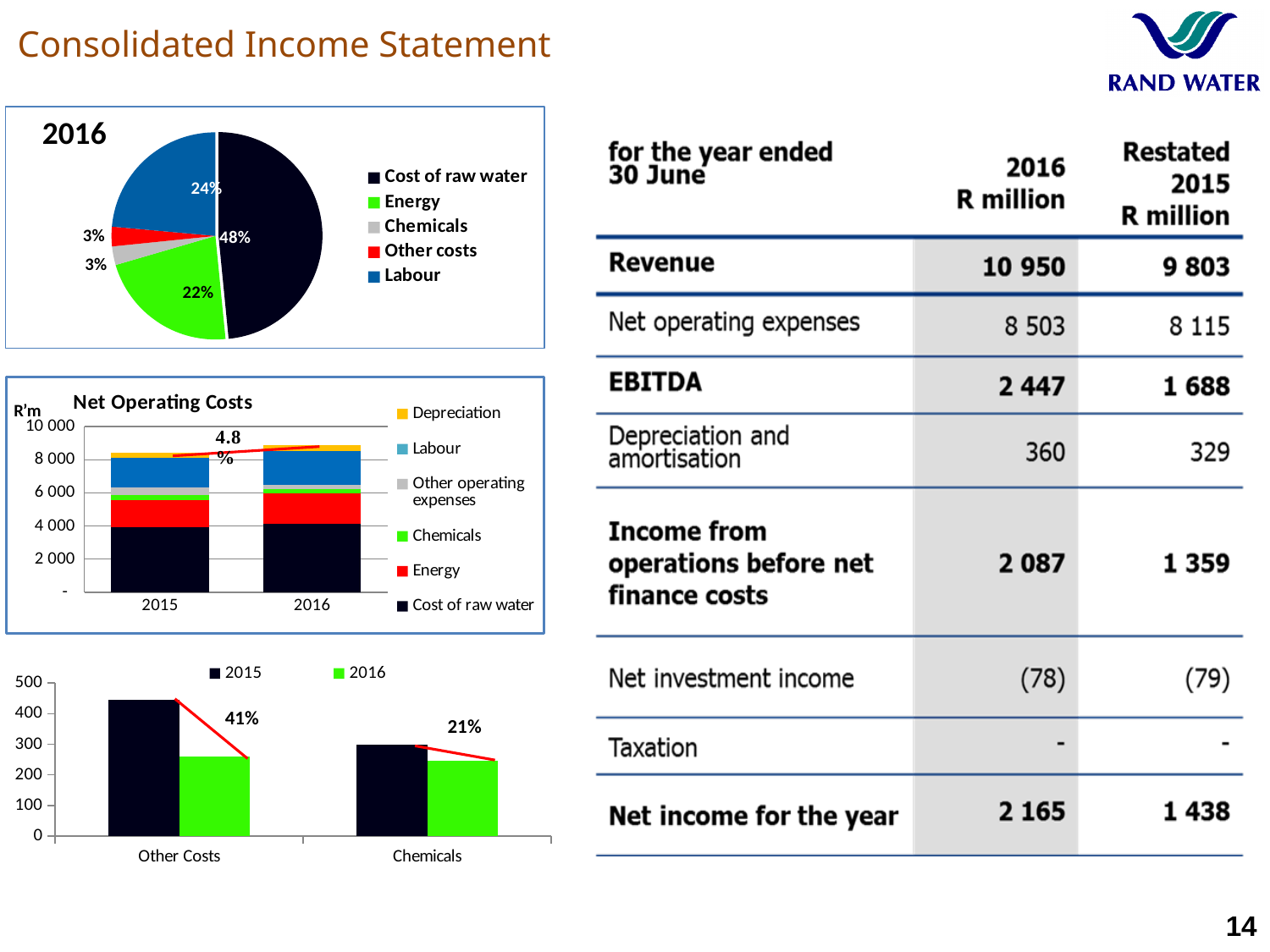
In the Net Operating Costs chart, how many series does the legend list? 6 In the bottom-left bar chart, is the 2015 value for Other Costs greater or less than 400? greater In the bottom-left bar chart, what percentage label is shown for Chemicals? 21% In the Net Operating Costs chart, what percentage is printed above the bars? 4.8% In the Net Operating Costs chart, is the total for 2016 greater or less than 8 000? greater In the 2016 pie chart, which category has the largest share? Cost of raw water In the 2016 pie chart, how many slices are there? 5 In the 2016 pie chart, what share does Cost of raw water have? 48% In the 2016 pie chart, what share does Labour have? 24% In the bottom-left bar chart, which is larger for Other Costs: the 2015 value or the 2016 value? 2015 What type of chart is the 2016 chart at the top left? Pie chart In the 2016 pie chart, what is the difference in percentage points between the Energy share and the Labour share? 2 percentage points